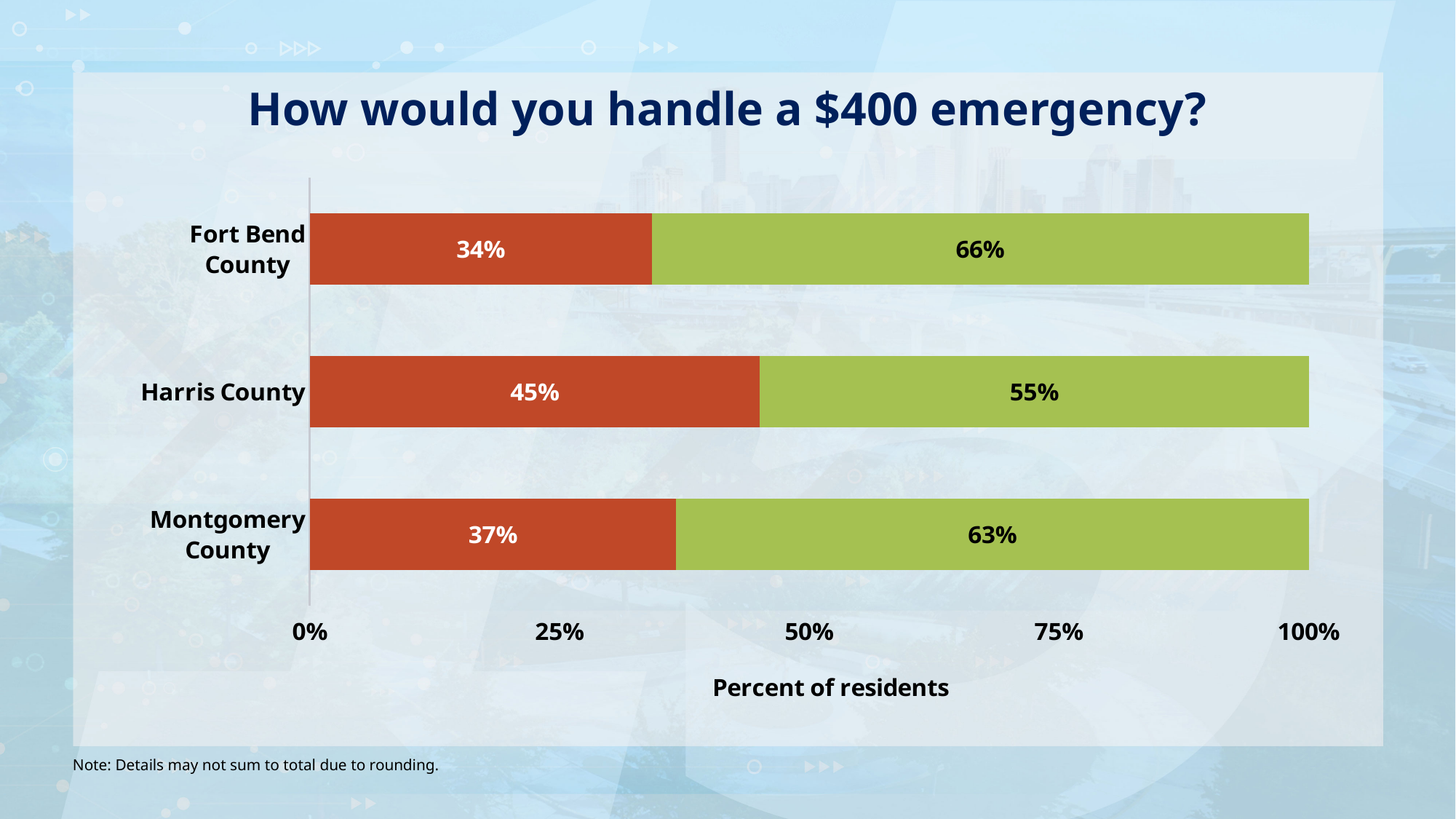
Which is larger: the green segment for Montgomery County or the green segment for Harris County? Montgomery County What kind of chart is shown on the slide? Stacked bar chart Which county has the highest value for the red segment? Harris County What is the value of the red segment for Montgomery County? 37% Which county has the lowest value for the green segment? Harris County What is the difference between the red segment values for Harris County and Fort Bend County? 11% What is the value of the green segment for Harris County? 55% What is the title of the chart? How would you handle a $400 emergency? What is the value of the green segment for Fort Bend County? 66% How many counties are shown on the chart? 3 What is the total of the stacked bar for Fort Bend County? 100% What is the value of the red segment for Harris County? 45%